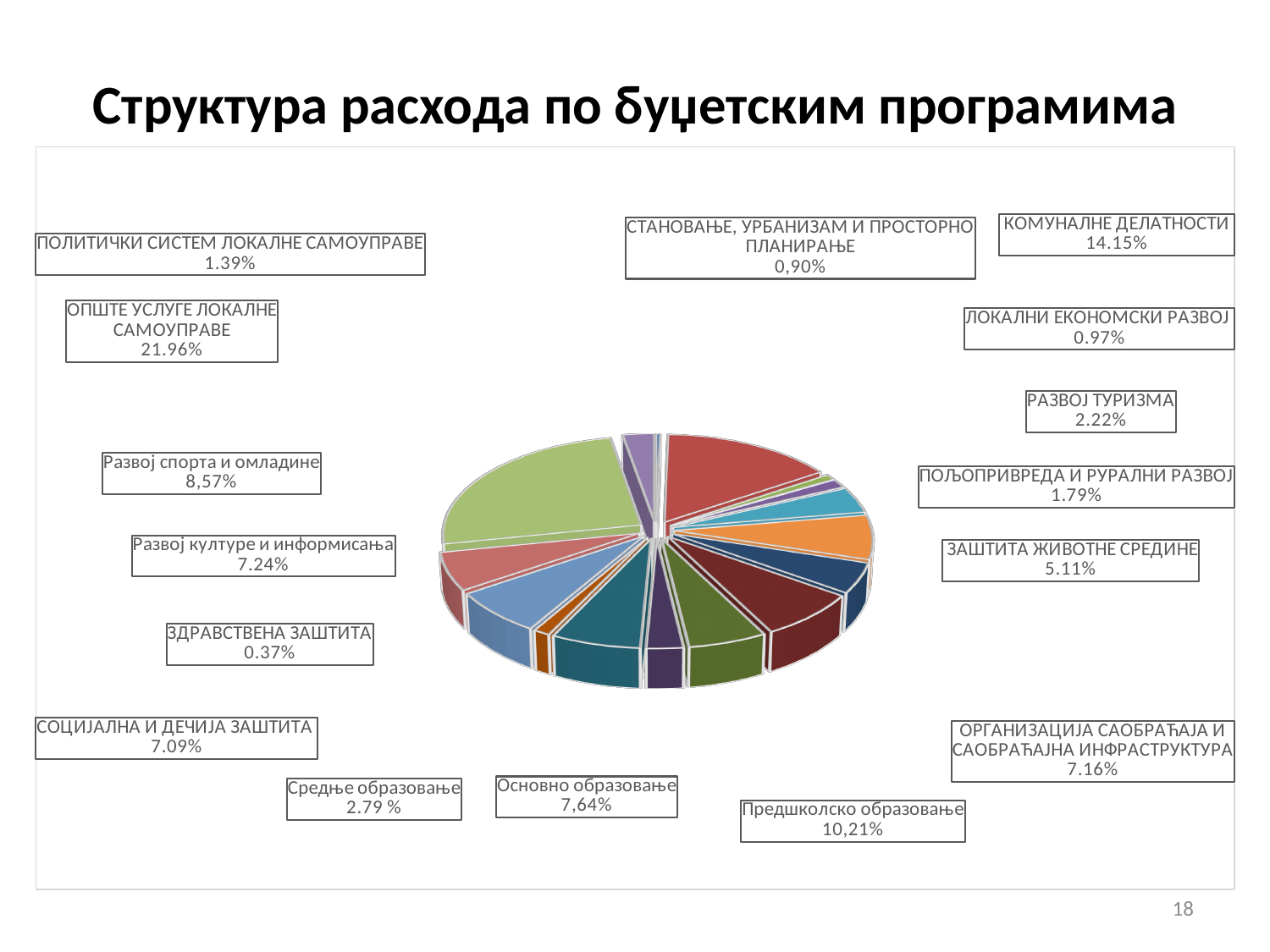
What type of chart is shown on the slide? Pie chart What share is shown for КОМУНАЛНЕ ДЕЛАТНОСТИ? 14.15% Which budget program has the largest share in the pie chart? ОПШТЕ УСЛУГЕ ЛОКАЛНЕ САМОУПРАВЕ What share is shown for ЗАШТИТА ЖИВОТНЕ СРЕДИНЕ? 5.11% What is the difference in percentage points between ОПШТЕ УСЛУГЕ ЛОКАЛНЕ САМОУПРАВЕ and КОМУНАЛНЕ ДЕЛАТНОСТИ? 7.81 Which budget program has the smallest share in the pie chart? ЗДРАВСТВЕНА ЗАШТИТА Which has a larger share, Развој спорта и омладине or Основно образовање? Развој спорта и омладине What is the title of the chart on the slide? Структура расхода по буџетским програмима How many budget programs (slices) are labelled in the pie chart? 16 What share is shown for Предшколско образовање? 10,21% What share is shown for РАЗВОЈ ТУРИЗМА? 2.22% What share is shown for ОПШТЕ УСЛУГЕ ЛОКАЛНЕ САМОУПРАВЕ? 21.96%